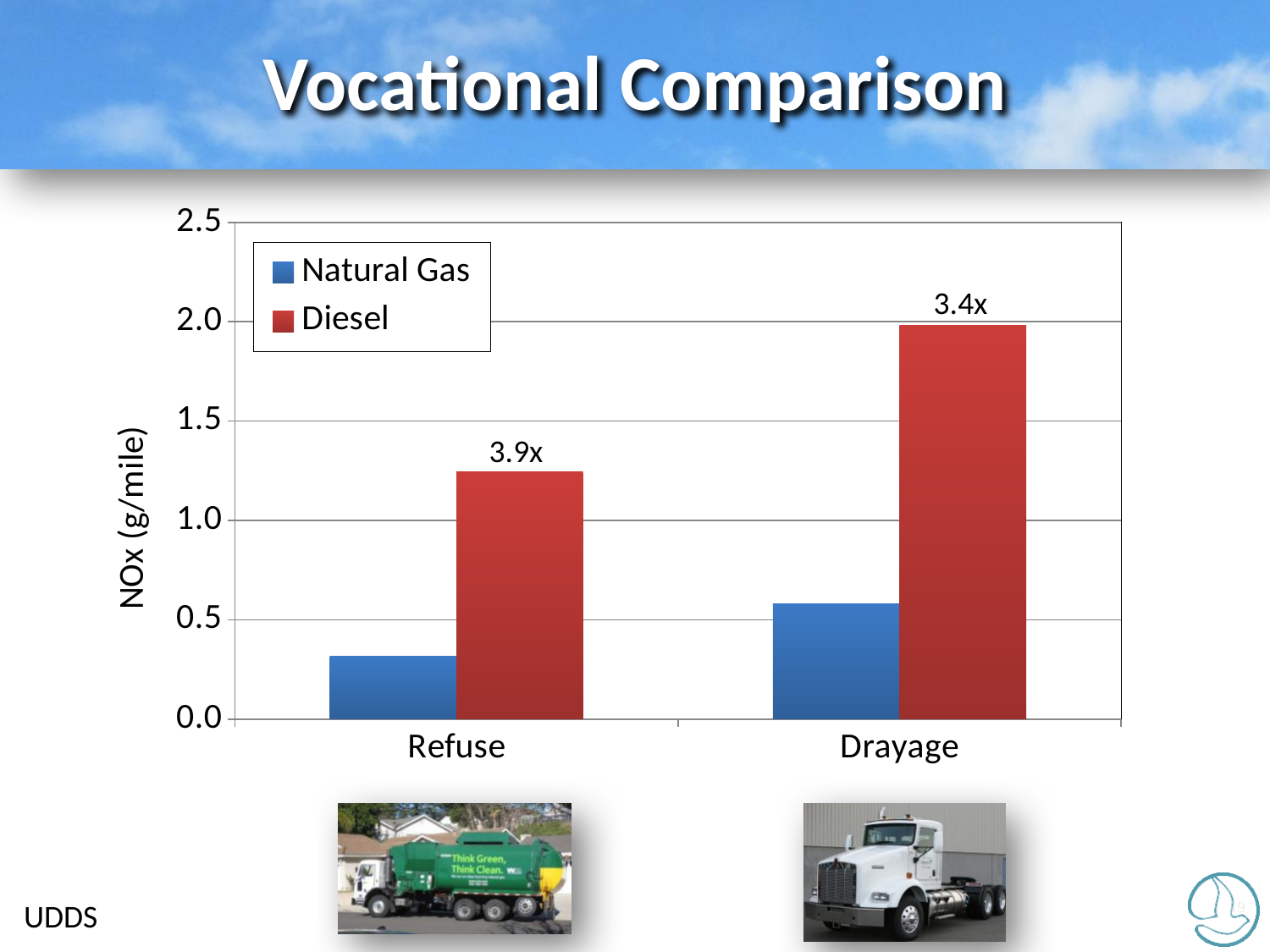
How many series does the legend list? 2 Which bar is the highest in the chart? Diesel for Drayage What label is printed above the Diesel bar for Drayage? 3.4x What is the label on the y axis? NOx (g/mile) How many categories are shown on the x axis? 2 What kind of chart is shown on the slide? bar chart For Refuse, which is larger: Natural Gas or Diesel? Diesel Is the Natural Gas value for Refuse greater or less than 0.5? less Which bar is the lowest in the chart? Natural Gas for Refuse For Natural Gas, which category has the larger value: Refuse or Drayage? Drayage What label is printed above the Diesel bar for Refuse? 3.9x Is the Diesel value for Refuse greater or less than 1.0? greater